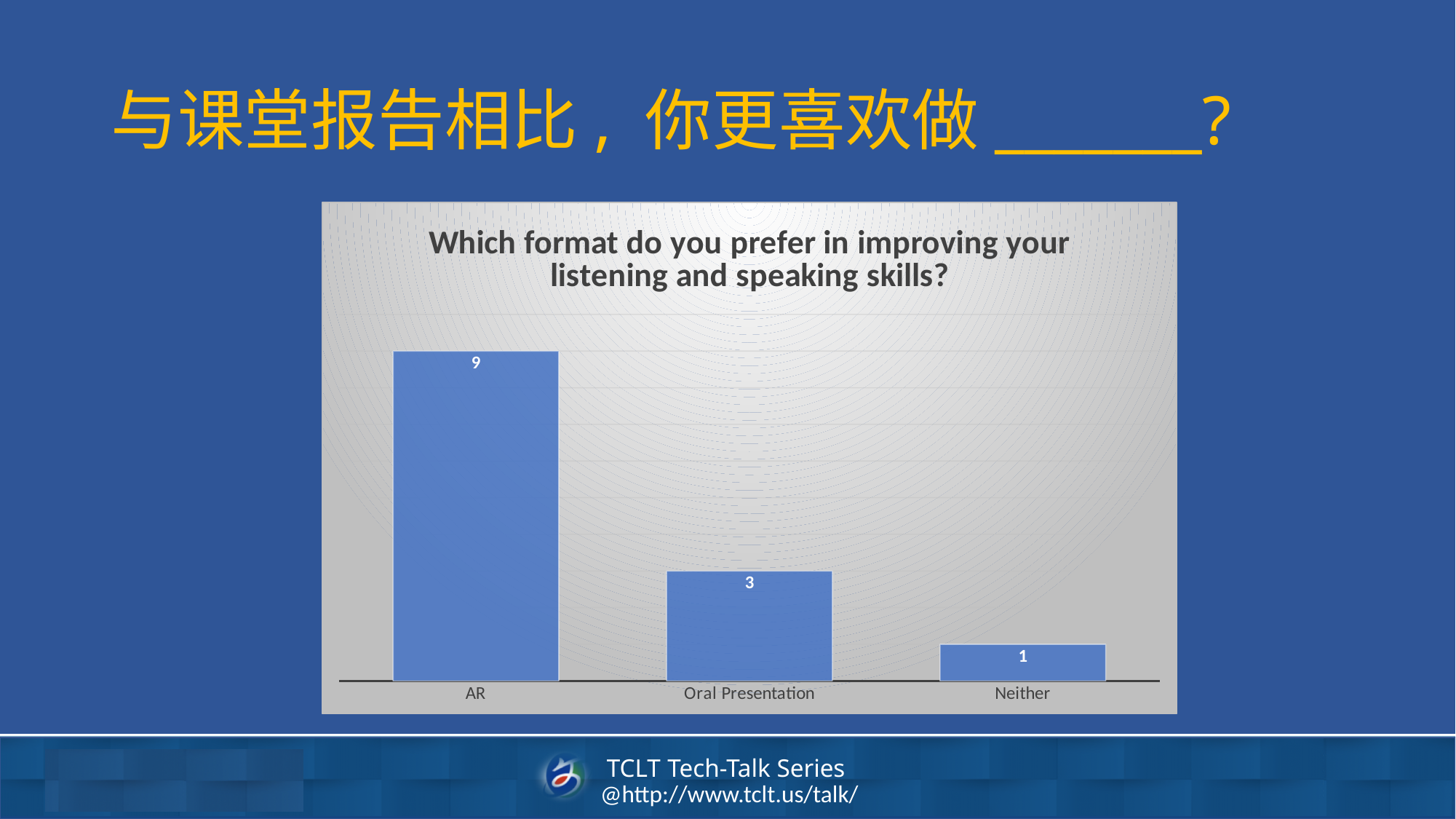
What is the value for AR? 9 Which category has the lowest value? Neither What is the value for Oral Presentation? 3 How many categories are shown in the chart? 3 What is the value for Neither? 1 What is the difference between the values for Oral Presentation and Neither? 2 Which is larger, the value for AR or the value for Neither? AR What is the difference between the values for AR and Oral Presentation? 6 What kind of chart is shown on the slide? Bar chart Which category has the highest value? AR Do the values rise or fall from left to right across the categories? Fall What is the title of the chart? Which format do you prefer in improving your listening and speaking skills?